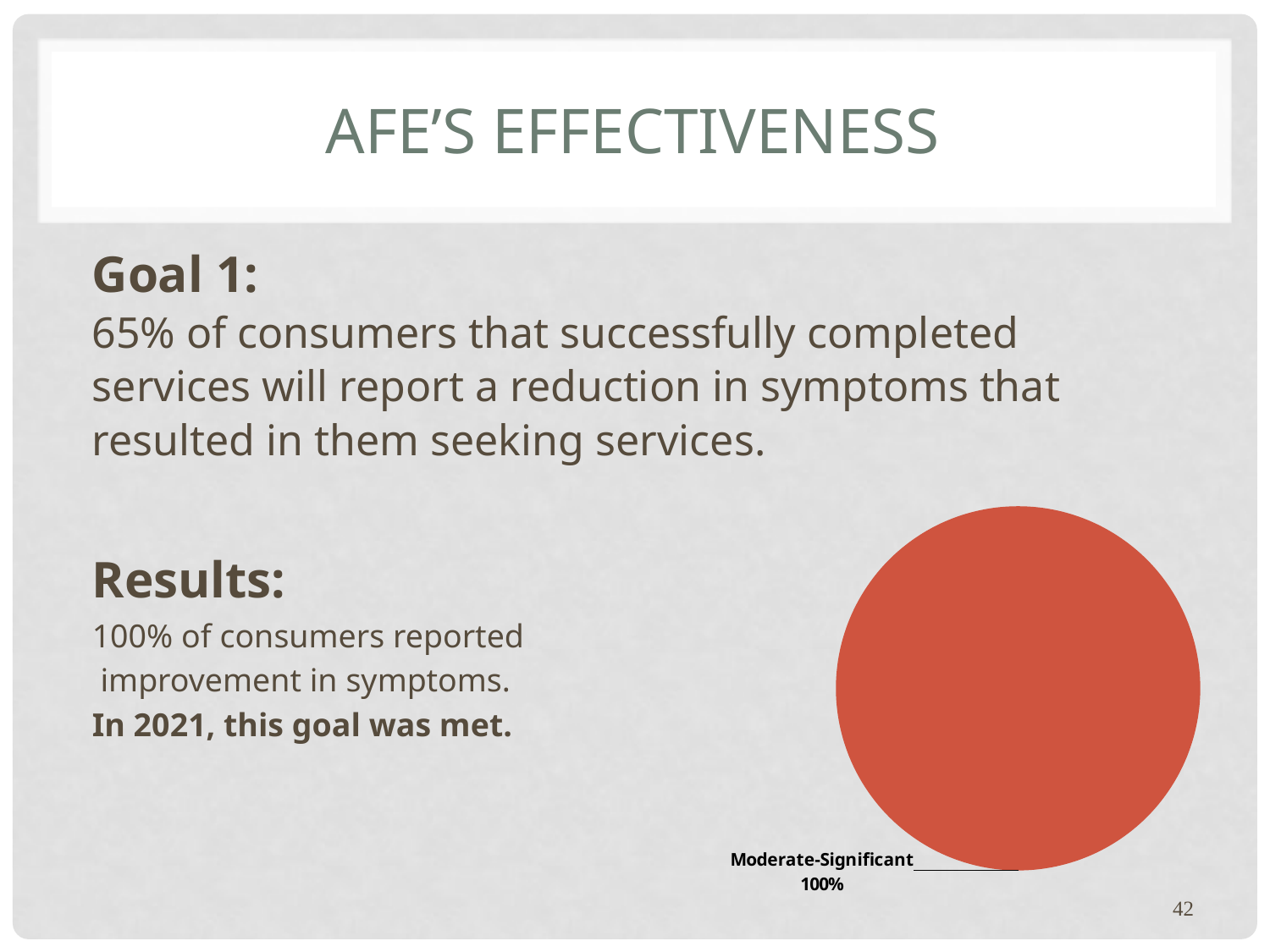
What kind of chart is shown on the slide? pie chart How many slices does the pie chart have? 1 What is the label of the only slice in the pie chart? Moderate-Significant What is the value shown for the Moderate-Significant category in the pie chart? 100% What share of the pie does the Moderate-Significant slice represent? 100% What colour is the slice in the pie chart? red-orange